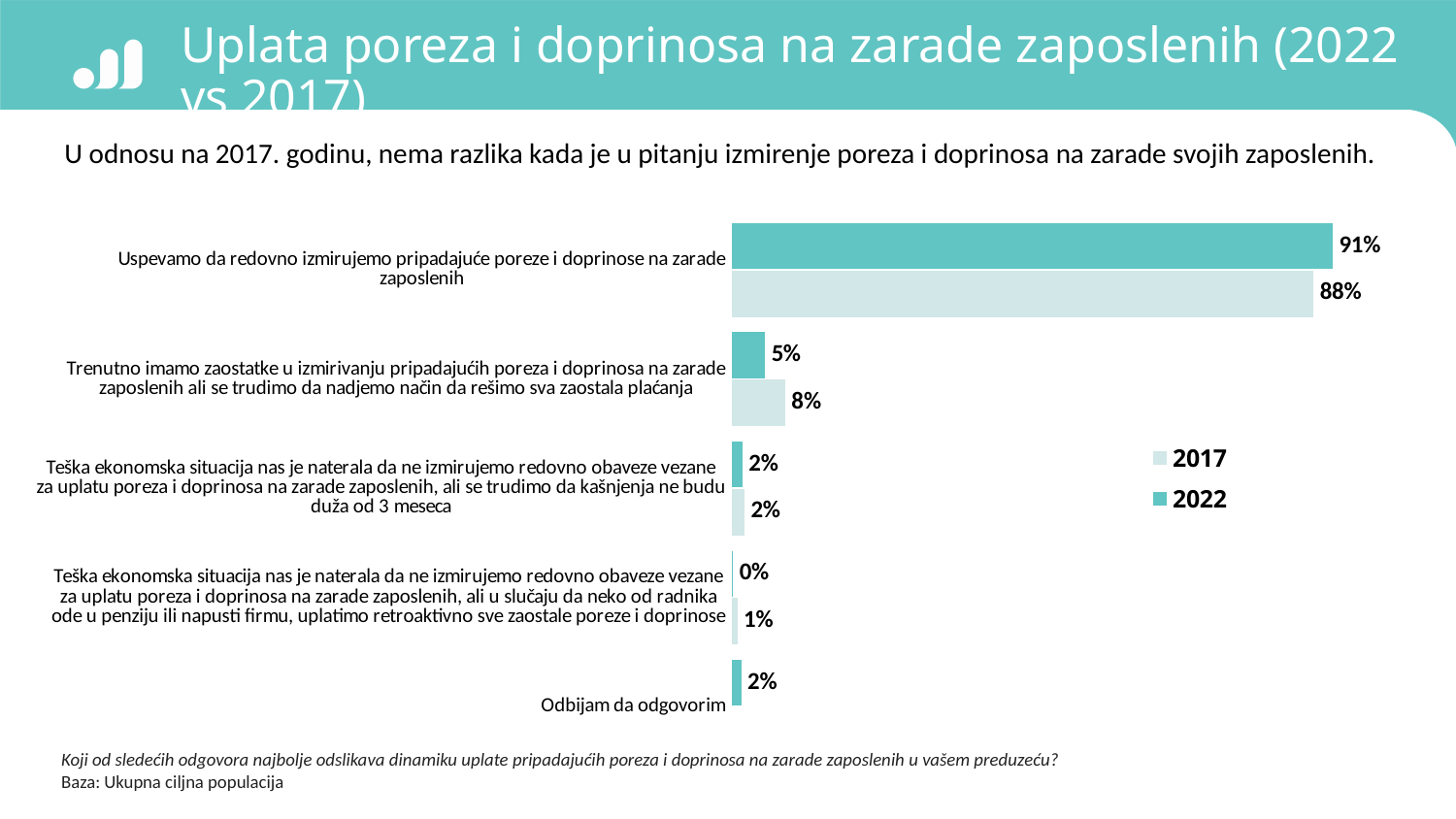
How many series does the legend list? 2 Which series is shown in the darker teal colour? 2022 What is the 2022 value for "Trenutno imamo zaostatke u izmirivanju pripadajućih poreza i doprinosa na zarade zaposlenih ali se trudimo da nadjemo način da rešimo sva zaostala plaćanja"? 5% What kind of chart is shown on the slide? bar chart What is the 2022 value for "Uspevamo da redovno izmirujemo pripadajuće poreze i doprinose na zarade zaposlenih"? 91% Which category has the highest 2022 value? Uspevamo da redovno izmirujemo pripadajuće poreze i doprinose na zarade zaposlenih What is the 2017 value for "Trenutno imamo zaostatke u izmirivanju pripadajućih poreza i doprinosa na zarade zaposlenih ali se trudimo da nadjemo način da rešimo sva zaostala plaćanja"? 8% What is the 2017 value for "Uspevamo da redovno izmirujemo pripadajuće poreze i doprinose na zarade zaposlenih"? 88% What is the 2022 value for "Odbijam da odgovorim"? 2% What is the difference between the 2022 and 2017 values for "Uspevamo da redovno izmirujemo pripadajuće poreze i doprinose na zarade zaposlenih"? 3% For "Trenutno imamo zaostatke u izmirivanju pripadajućih poreza i doprinosa na zarade zaposlenih ali se trudimo da nadjemo način da rešimo sva zaostala plaćanja", which year has the larger value, 2017 or 2022? 2017 How many categories are shown on the chart? 5